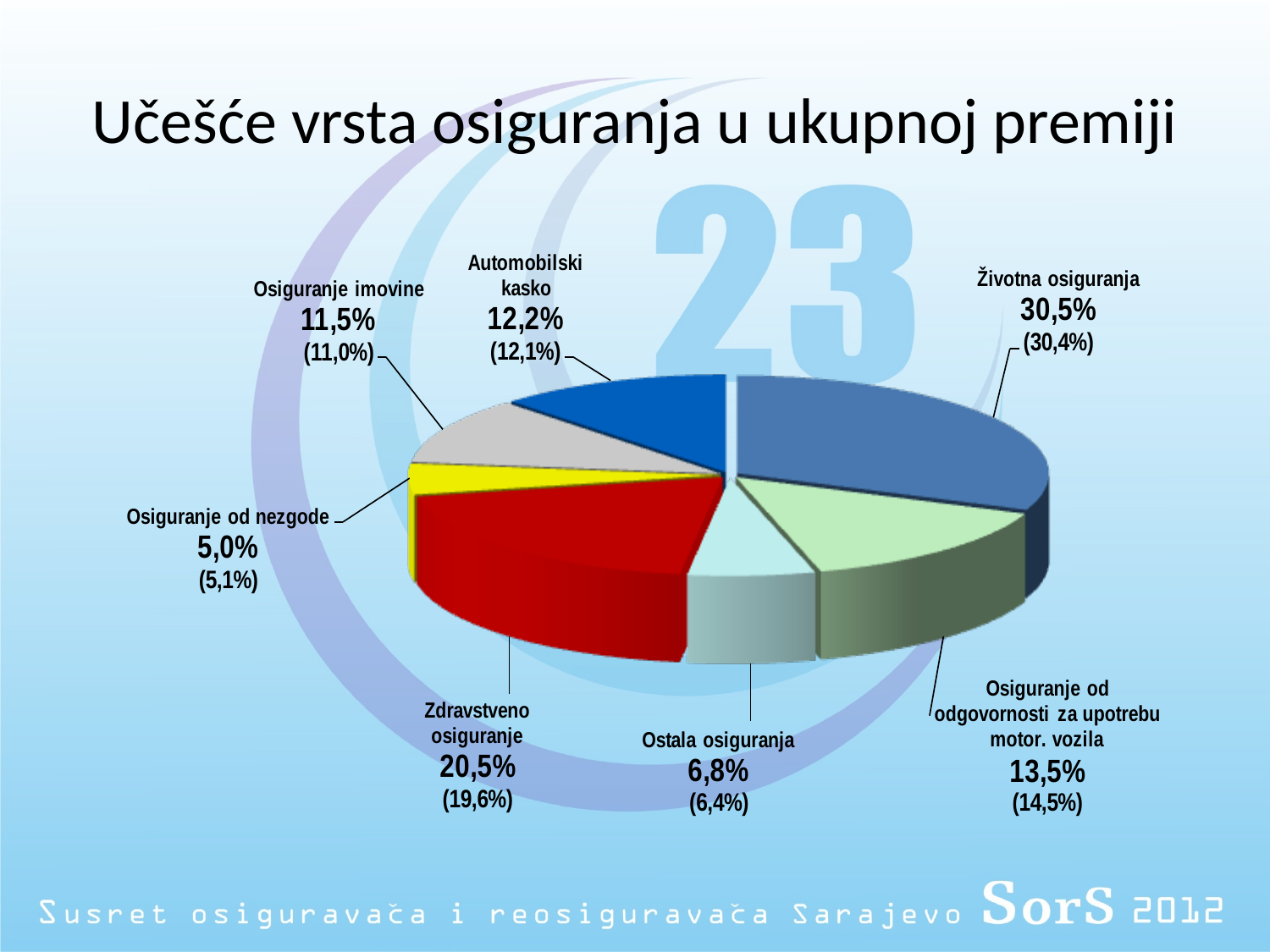
What value is shown for Osiguranje od nezgode? 5,0% What is the title of the slide? Učešće vrsta osiguranja u ukupnoj premiji Which type of insurance has the smallest share of the total premium? Osiguranje od nezgode How many slices does the pie chart have? 7 What is the share shown for Zdravstveno osiguranje? 20,5% Which has a larger share, Osiguranje imovine or Automobilski kasko? Automobilski kasko What is the difference between the shares of Životna osiguranja and Zdravstveno osiguranje? 10,0% What kind of chart is shown on the slide? Pie chart What is the value in parentheses shown for Automobilski kasko? (12,1%) Which type of insurance has the largest share of the total premium? Životna osiguranja What share is shown for Osiguranje od odgovornosti za upotrebu motor. vozila? 13,5% What share of the total premium does Životna osiguranja hold? 30,5%